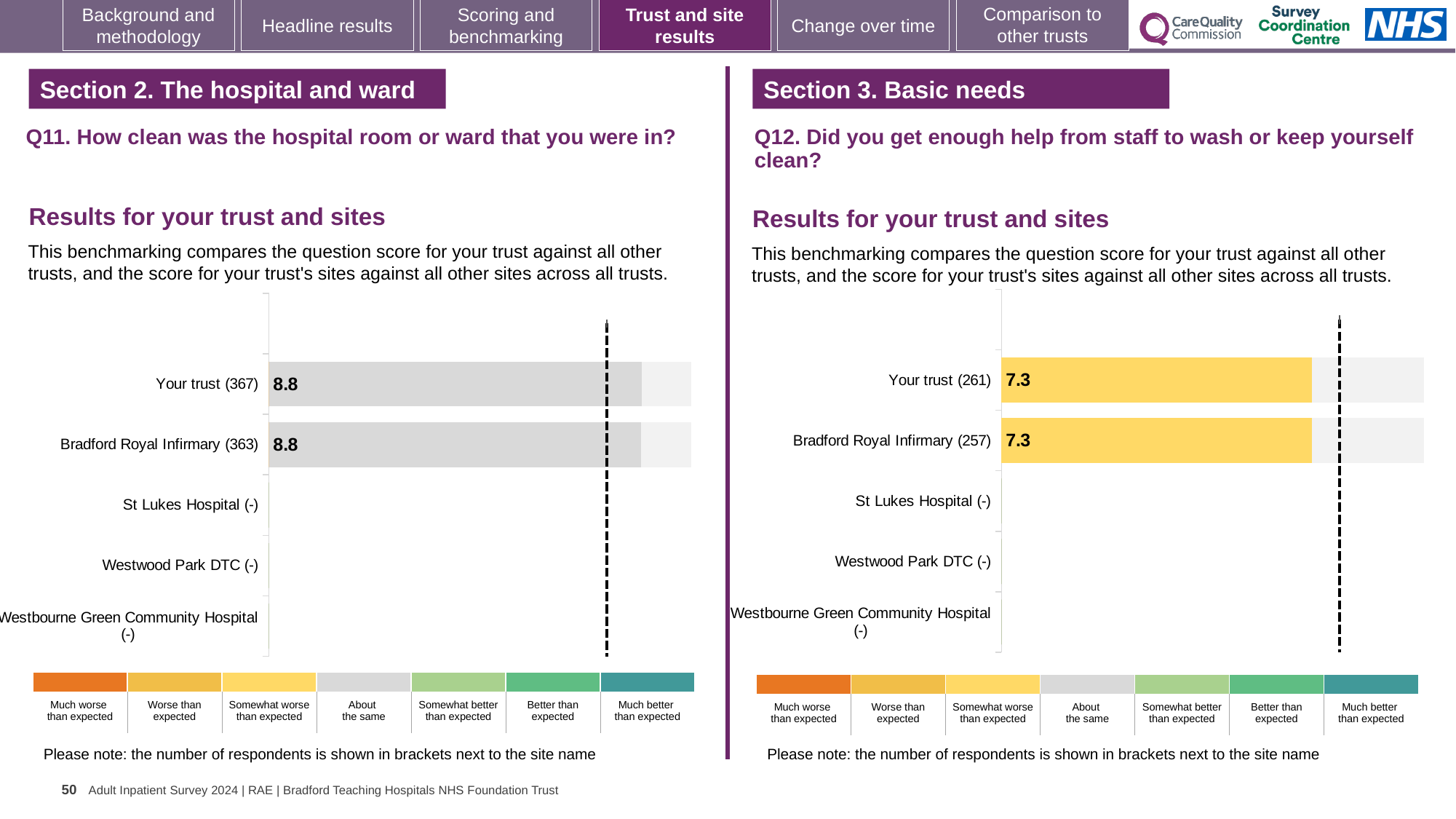
In the Q11 chart on the left, what is the score for Bradford Royal Infirmary (363)? 8.8 In the Q11 chart on the left, what is the score for Your trust (367)? 8.8 In the Q11 chart on the left, what is the difference between the score for Your trust and the score for Bradford Royal Infirmary? 0 How many site or trust categories are listed on the y axis of the Q11 chart on the left? 5 In the Q12 chart on the right, what is the score for Your trust (261)? 7.3 In the Q11 chart on the left, how many categories have a plotted bar with a score? 2 In the Q12 chart on the right, what is the score for Bradford Royal Infirmary (257)? 7.3 In the Q12 chart on the right, which benchmark category does the yellow colour of the bars correspond to in the key? Somewhat worse than expected Is the score for Your trust in the Q12 chart on the right larger or smaller than the score for Your trust in the Q11 chart on the left? Smaller What kind of chart is used for the Q11 results on the left? Bar chart How many site or trust categories are listed on the y axis of the Q12 chart on the right? 5 In the Q11 chart on the left, which benchmark category does the grey colour of the bars correspond to in the key? About the same